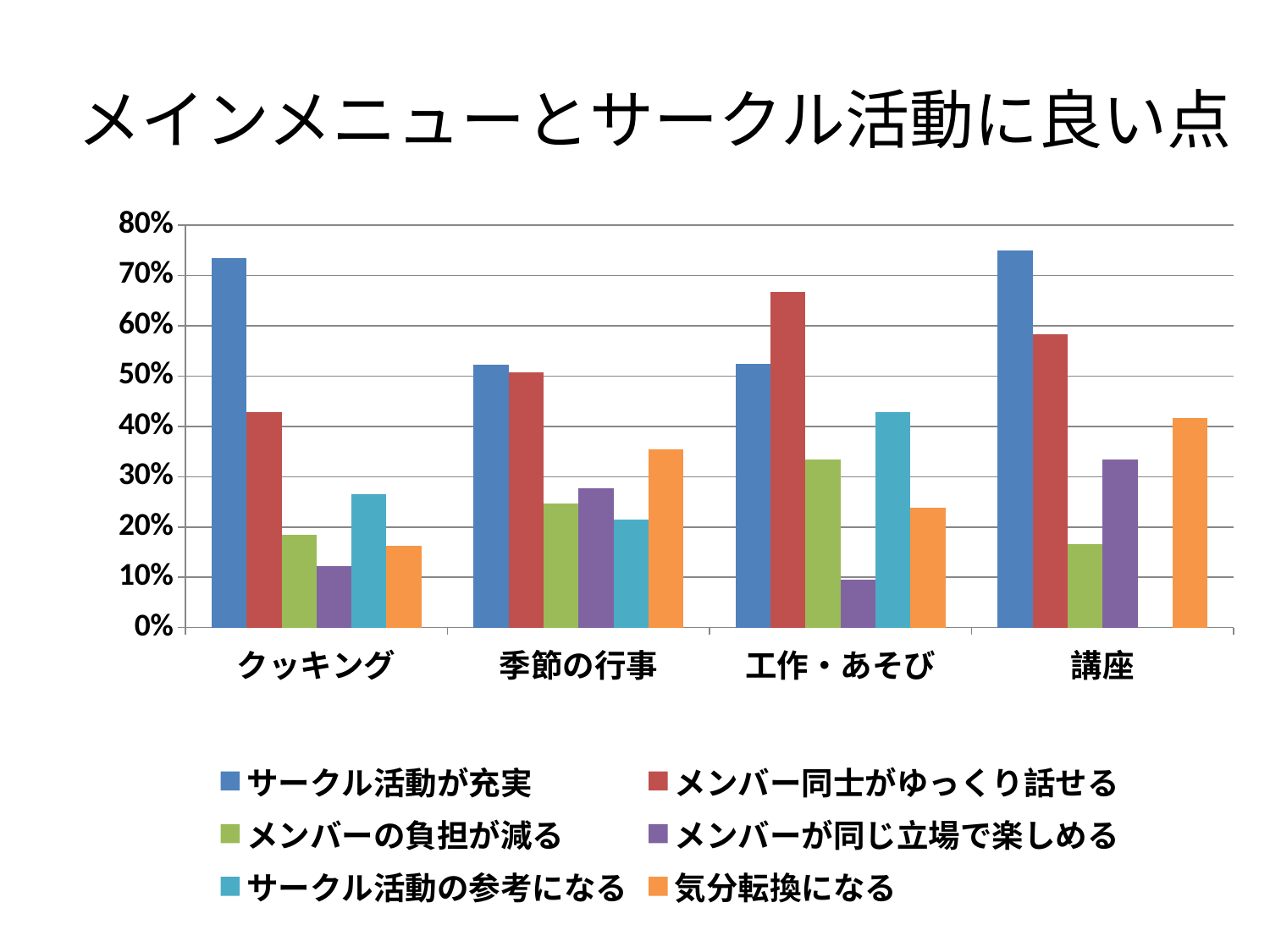
In 工作・あそび, which is larger: サークル活動が充実 or メンバー同士がゆっくり話せる? メンバー同士がゆっくり話せる What is the title of the slide? メインメニューとサークル活動に良い点 Is the value for サークル活動が充実 in クッキング greater or less than 70%? greater In 講座, which is larger: 気分転換になる or メンバーが同じ立場で楽しめる? 気分転換になる Is the value for メンバーが同じ立場で楽しめる in 工作・あそび greater or less than 20%? less What kind of chart is shown on the slide? bar chart How many categories are shown along the x axis? 4 Which category has the lowest value for 気分転換になる? クッキング Which category has the highest value for メンバー同士がゆっくり話せる? 工作・あそび Which series has no bar shown for the 講座 category? サークル活動の参考になる How many series does the legend list? 6 Is the value for 気分転換になる in 季節の行事 greater or less than 30%? greater